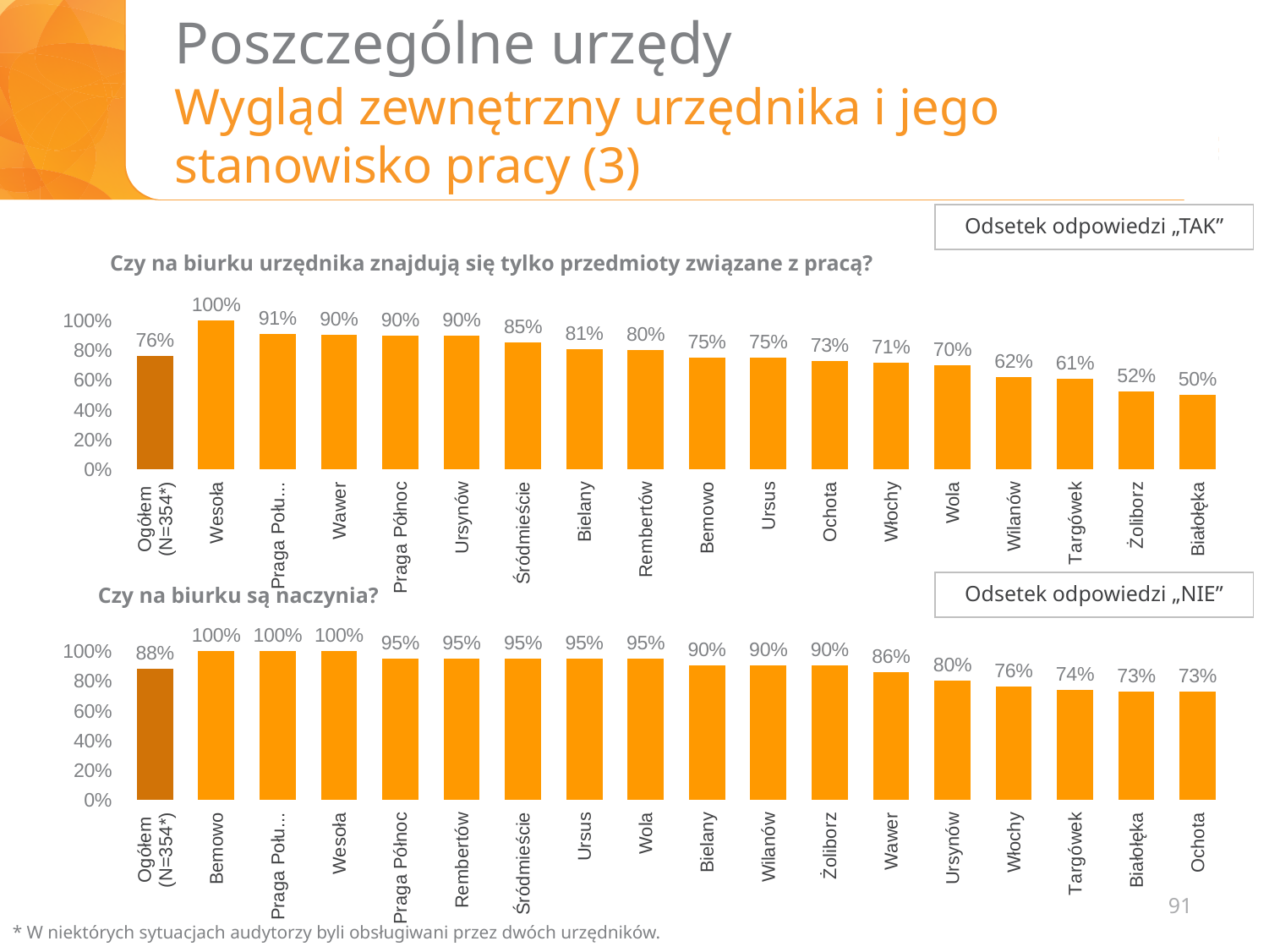
In the top chart ("Czy na biurku urzędnika znajdują się tylko przedmioty związane z pracą?"), how many bars are shown? 18 What type of chart is the bottom chart ("Czy na biurku są naczynia?")? Bar chart In the bottom chart ("Czy na biurku są naczynia?"), what is the difference between Bemowo and Ochota? 27 percentage points In the top chart ("Czy na biurku urzędnika znajdują się tylko przedmioty związane z pracą?"), which district has the lowest value? Białołęka In the bottom chart ("Czy na biurku są naczynia?"), what is the value for Ursynów? 80% In the bottom chart ("Czy na biurku są naczynia?"), do the values rise or fall from left to right after the Ogółem bar? Fall In the top chart ("Czy na biurku urzędnika znajdują się tylko przedmioty związane z pracą?"), what is the difference between Wesoła and Białołęka? 50 percentage points In the bottom chart ("Czy na biurku są naczynia?"), what is the value for Wawer? 86% In the bottom chart ("Czy na biurku są naczynia?"), what is the value for Ogółem (N=354*)? 88% In the top chart ("Czy na biurku urzędnika znajdują się tylko przedmioty związane z pracą?"), which is larger, Bielany or Wola? Bielany In the top chart ("Czy na biurku urzędnika znajdują się tylko przedmioty związane z pracą?"), what is the value for Wesoła? 100% In the top chart ("Czy na biurku urzędnika znajdują się tylko przedmioty związane z pracą?"), what is the value for Ogółem (N=354*)? 76%